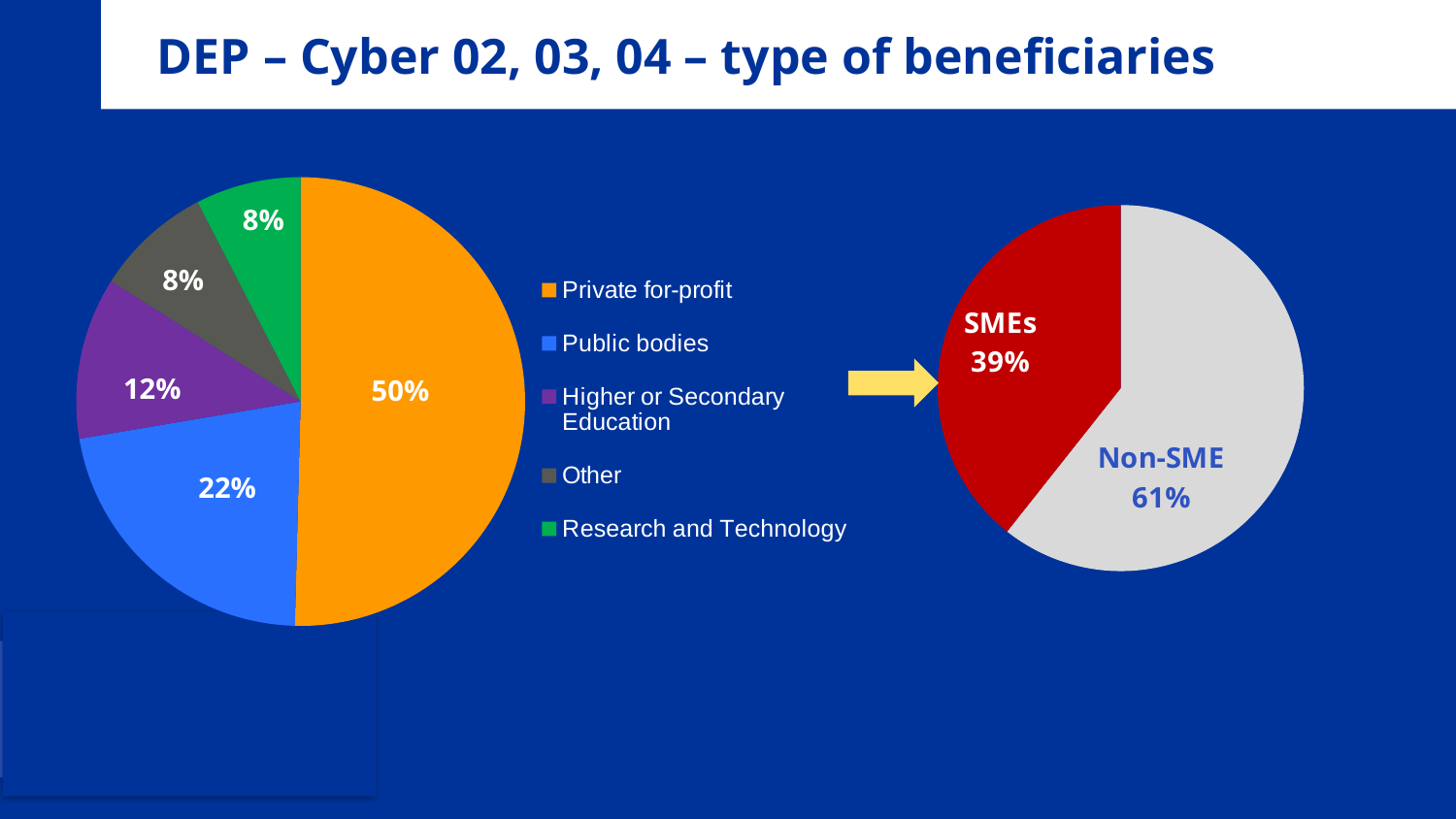
In the left pie chart, what share is Private for-profit? 50% In the left pie chart, what share is Higher or Secondary Education? 12% What kind of chart is the left chart? Pie chart In the left pie chart, which is larger: Public bodies or Higher or Secondary Education? Public bodies In the left pie chart, what share is Public bodies? 22% In the right pie chart, what share is SMEs? 39% How many categories does the legend of the left pie chart list? 5 In the right pie chart, which slice is larger: SMEs or Non-SME? Non-SME In the left pie chart, which category has the largest share? Private for-profit In the right pie chart, what share is Non-SME? 61% In the left pie chart, what colour is the Research and Technology slice? Green In the left pie chart, what is the difference between the Private for-profit share and the Public bodies share? 28%